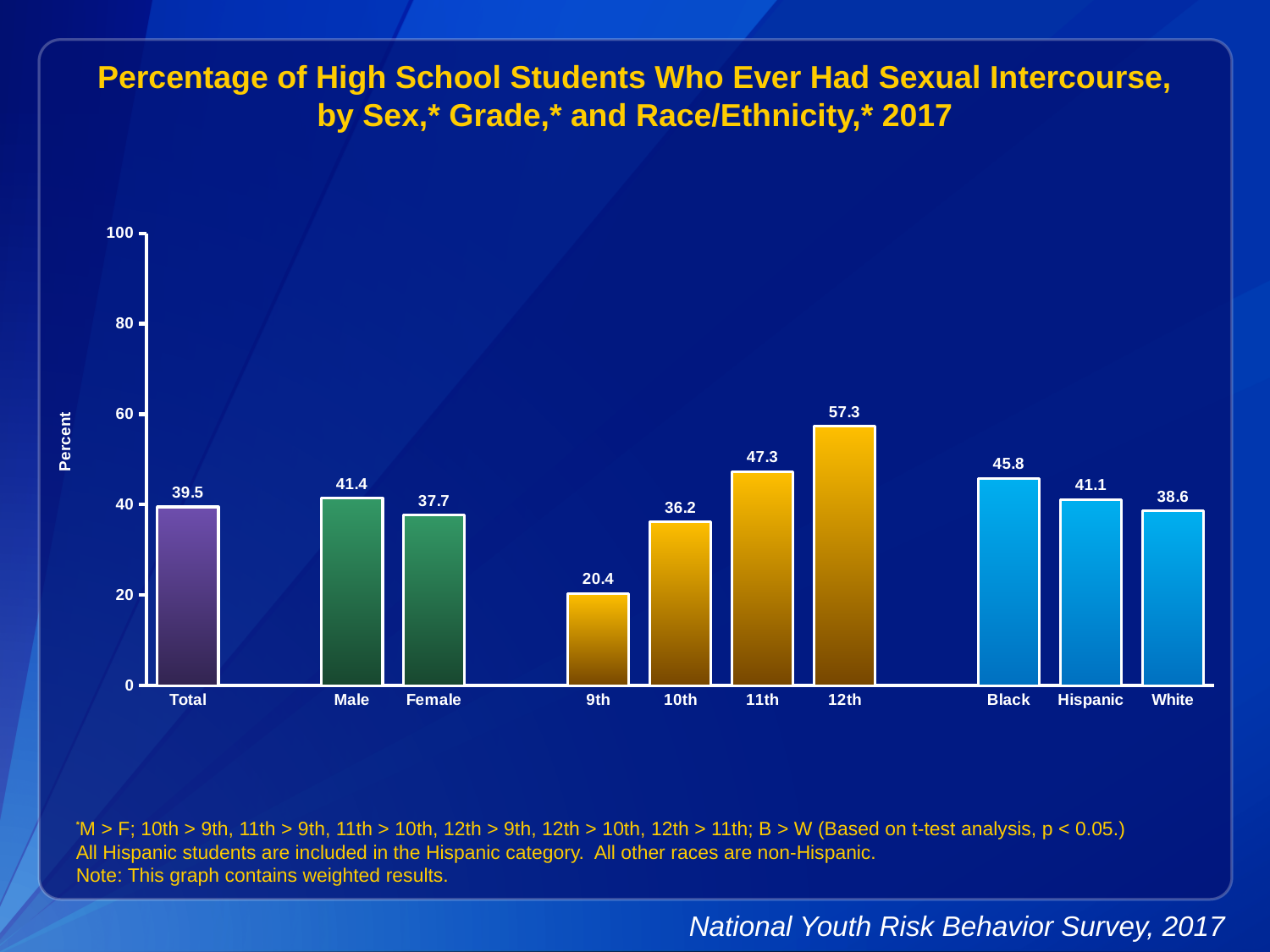
What is the value for Total? 39.5 What kind of chart is this? Bar chart Which category has the highest value? 12th What is the difference between the values for 12th and 9th grade? 36.9 How many categories are shown on the x axis? 10 What is the value for 12th grade students? 57.3 What is the difference between the values for Male and Female? 3.7 Which category has the lowest value? 9th Do the values rise or fall from 9th grade to 12th grade? Rise What is the value for Hispanic students? 41.1 Which is larger, the value for Black or the value for White? Black Is the value for 11th grade greater or less than 40? greater